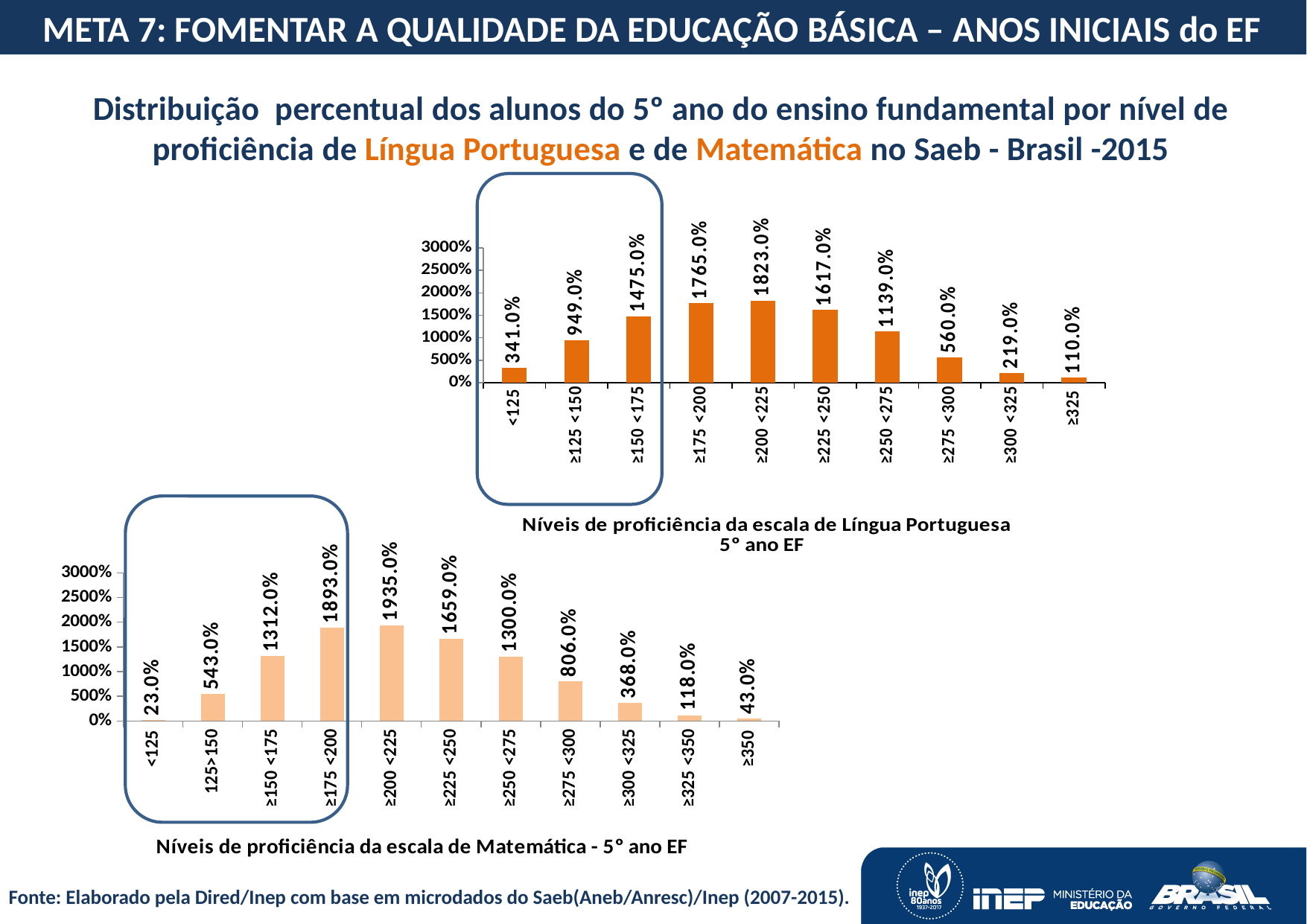
How many proficiency levels are shown in the Língua Portuguesa chart? 10 In the Matemática chart, what is the difference between the values for ≥200 <225 and ≥225 <250? 276.0% In the Matemática chart, what is the value for the ≥175 <200 level? 1893.0% In the Língua Portuguesa chart, do the values rise or fall from ≥200 <225 to ≥325? fall In the Língua Portuguesa chart, which proficiency level has the highest value? ≥200 <225 How many proficiency levels are shown in the Matemática chart? 11 In the Língua Portuguesa chart, what is the value for the ≥200 <225 level? 1823.0% In the Língua Portuguesa chart, what is the difference between the values for ≥175 <200 and ≥150 <175? 290.0% In the Matemática chart, which proficiency level has the lowest value? <125 What kind of chart is the Matemática chart? bar chart In the Matemática chart, which is larger: the value for ≥250 <275 or the value for ≥275 <300? ≥250 <275 In the Língua Portuguesa chart, is the value for ≥125 <150 greater or less than 1000%? less